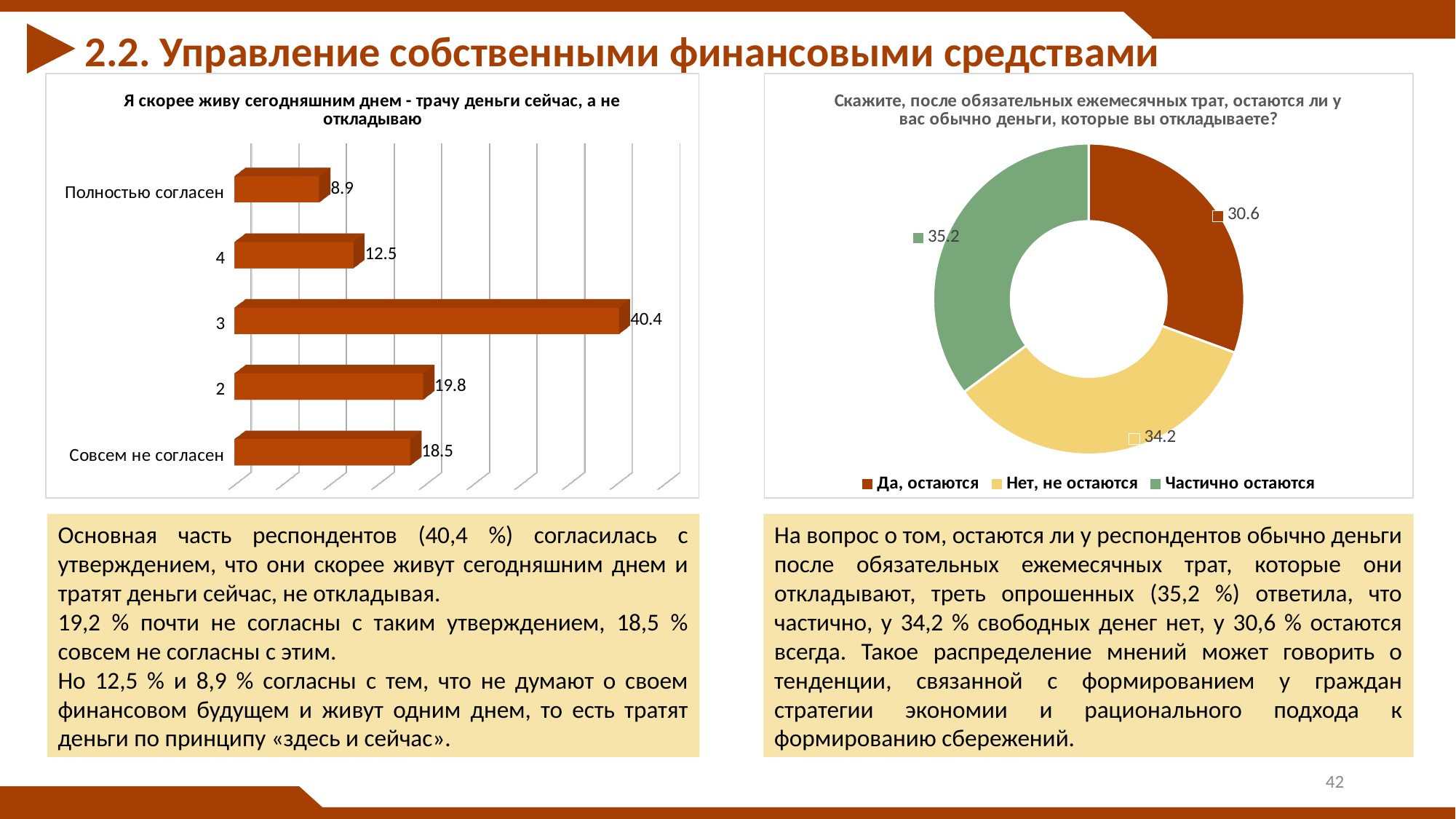
In the left bar chart, how many categories are shown? 5 In the right doughnut chart, which is larger: "Да, остаются" or "Нет, не остаются"? Нет, не остаются In the left chart titled "Я скорее живу сегодняшним днем - трачу деньги сейчас, а не откладываю", what is the value for "Полностью согласен"? 8.9 How many entries does the legend of the right chart list? 3 In the left bar chart, what is the value for "Совсем не согласен"? 18.5 In the left bar chart, what is the value for category "3"? 40.4 In the right doughnut chart, which category has the largest value? Частично остаются What kind of chart is the left chart on the slide? Bar chart In the left bar chart, which category has the lowest value? Полностью согласен In the left bar chart, which category has the highest value? 3 In the right chart titled "Скажите, после обязательных ежемесячных трат, остаются ли у вас обычно деньги, которые вы откладываете?", what is the value for "Нет, не остаются"? 34.2 In the left bar chart, what is the difference between the values for category "2" and category "4"? 7.3